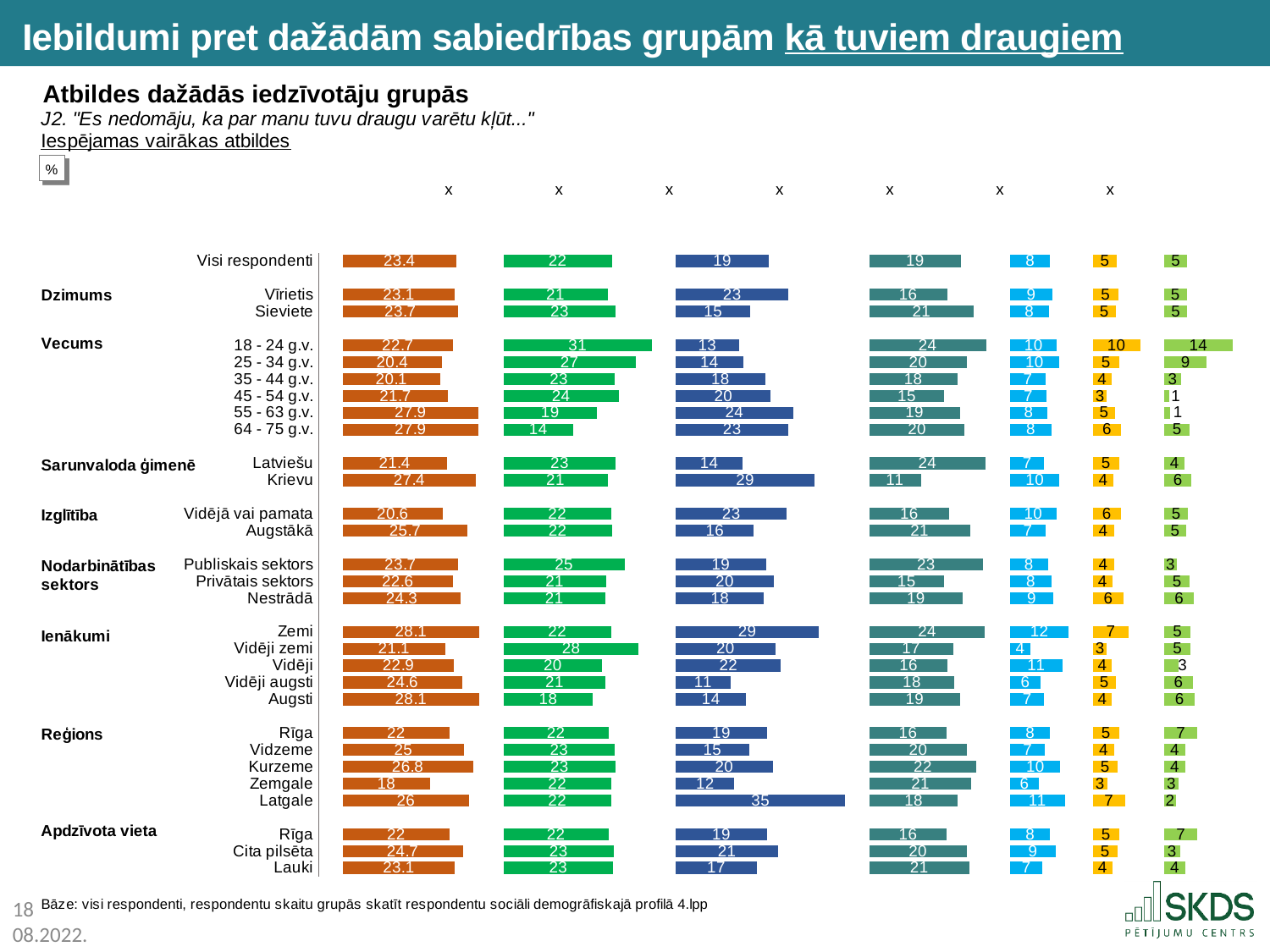
Among the Reģions rows, which region has the lowest value in the orange (first) series? Zemgale What unit is indicated for the values in the chart? % What is the value of the light green (last) bar for the 18 - 24 g.v. group? 14 For Visi respondenti, what is the difference between the orange (first) bar and the green (second) bar? 1.4 In the orange (first) series, which is larger: Latviešu or Krievu? Krievu What is the value of the teal (fourth) bar for the 18 - 24 g.v. group? 24 Among the Vecums (age) groups, which has the highest value in the green (second) series? 18 - 24 g.v. In the dark blue (third) series, what is the difference between Vīrietis and Sieviete? 8 What is the value of the dark blue (third) bar for Latgale? 35 How many bar series are plotted for each row of the chart? 7 What is the value of the orange (first) bar for Visi respondenti? 23.4 What type of chart is shown on the slide? bar chart